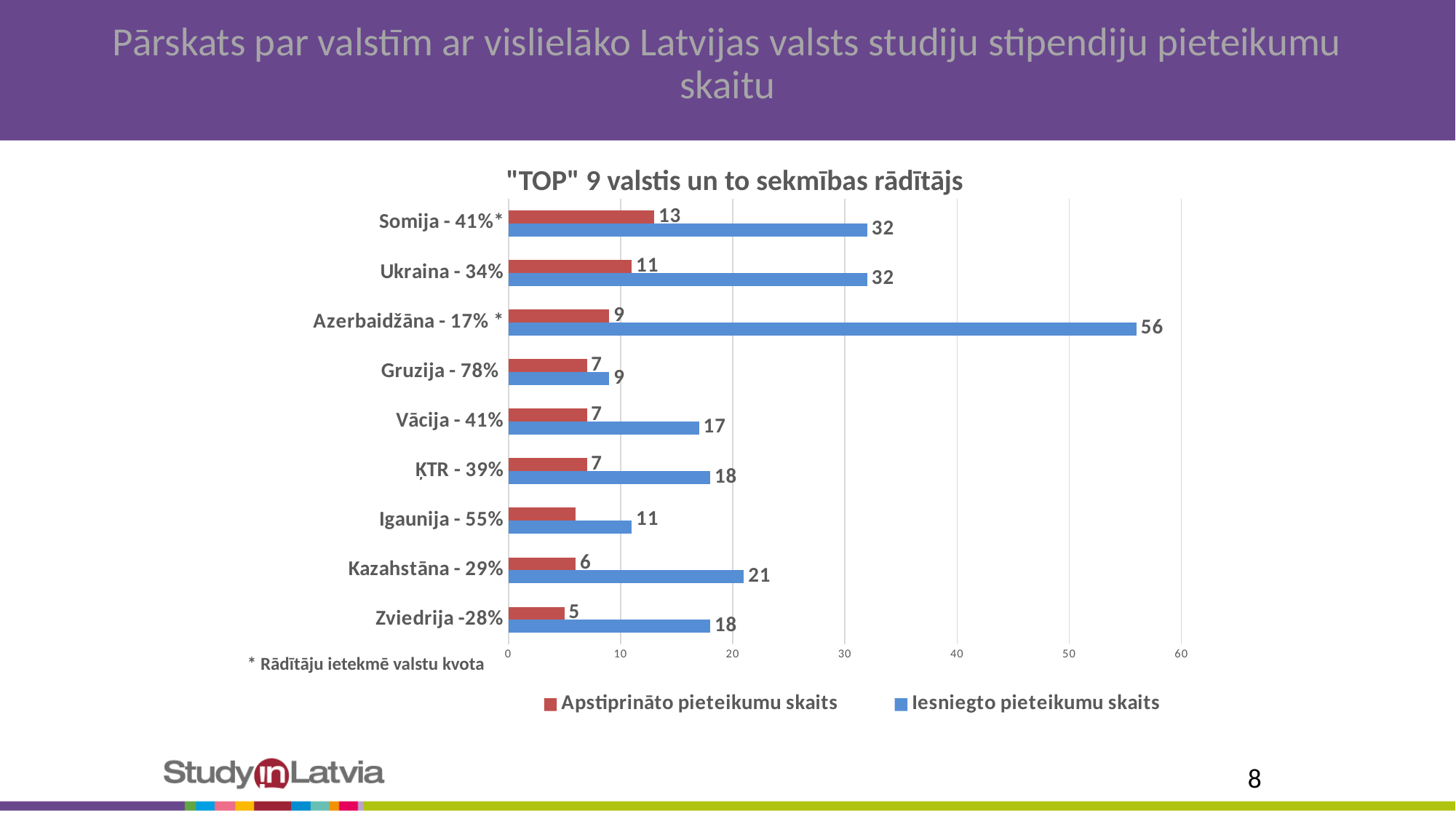
Which country has the highest Iesniegto pieteikumu skaits? Azerbaidžāna - 17% * What is the value of Iesniegto pieteikumu skaits for Azerbaidžāna - 17% *? 56 Is the value of Apstiprināto pieteikumu skaits for Igaunija - 55% greater or less than 10? less How many countries are shown in the chart? 9 What is the value of Apstiprināto pieteikumu skaits for Somija - 41%*? 13 Which country has the lowest Iesniegto pieteikumu skaits? Gruzija - 78% How many series does the legend list? 2 What is the difference between Iesniegto pieteikumu skaits and Apstiprināto pieteikumu skaits for Ukraina - 34%? 21 Which is larger: Iesniegto pieteikumu skaits for Vācija - 41% or for ĶTR - 39%? ĶTR - 39% What is the title of the chart? "TOP" 9 valstis un to sekmības rādītājs What is the value of Iesniegto pieteikumu skaits for Kazahstāna - 29%? 21 What type of chart is shown on the slide? bar chart